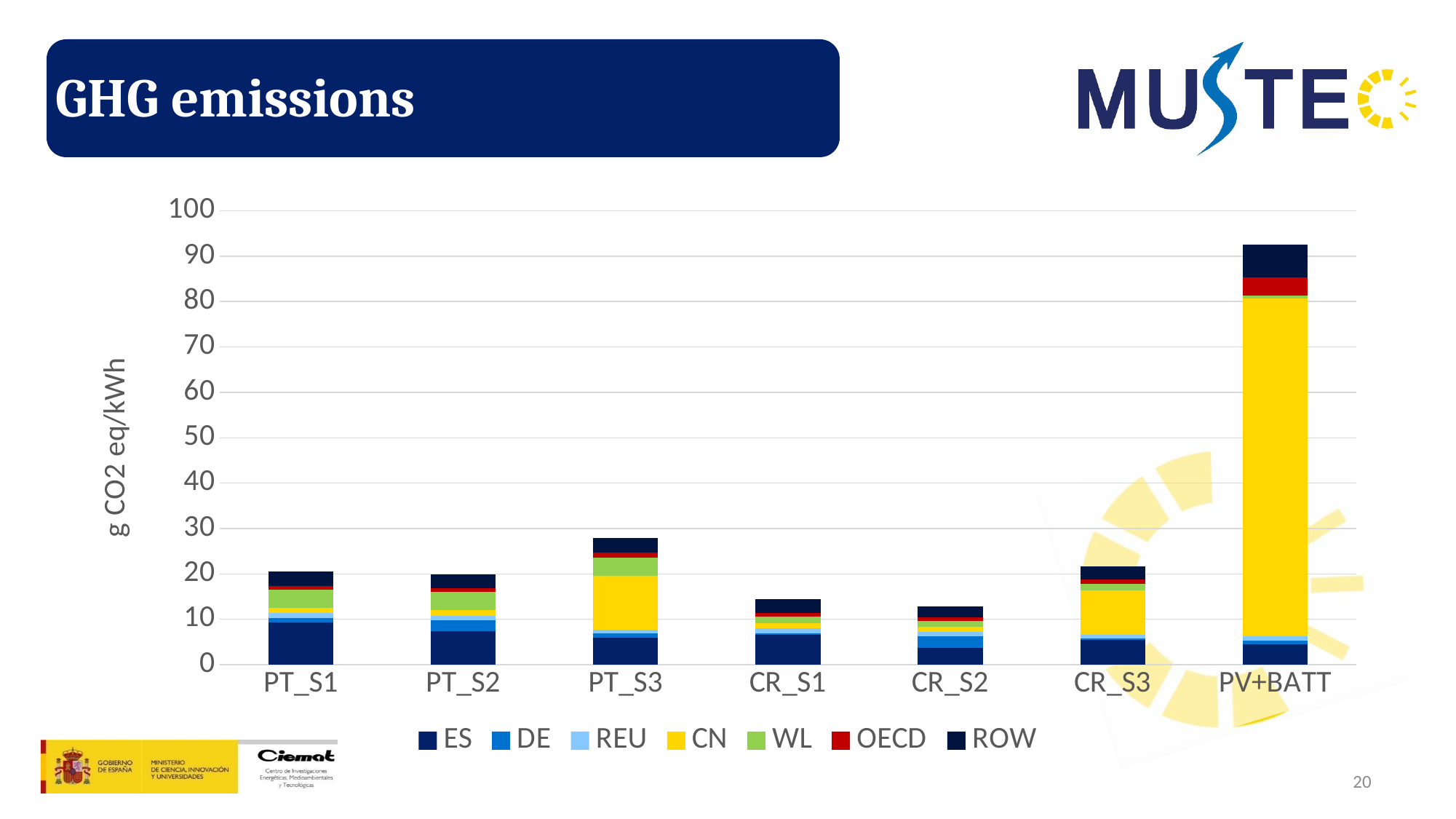
Which category has the highest total GHG emissions? PV+BATT Which has a larger total, PT_S3 or PT_S1? PT_S3 How many series does the chart legend list? 7 What is the label of the y axis? g CO2 eq/kWh Which has a larger total, CR_S3 or CR_S1? CR_S3 Is the total value for CR_S1 greater or less than 20? less How many categories are shown on the x axis of the chart? 7 Is the total value for PT_S3 greater or less than 30? less Is the total value for PT_S1 greater or less than 10? greater Which series is shown in yellow in the legend? CN What kind of chart is shown on the slide? Stacked bar chart